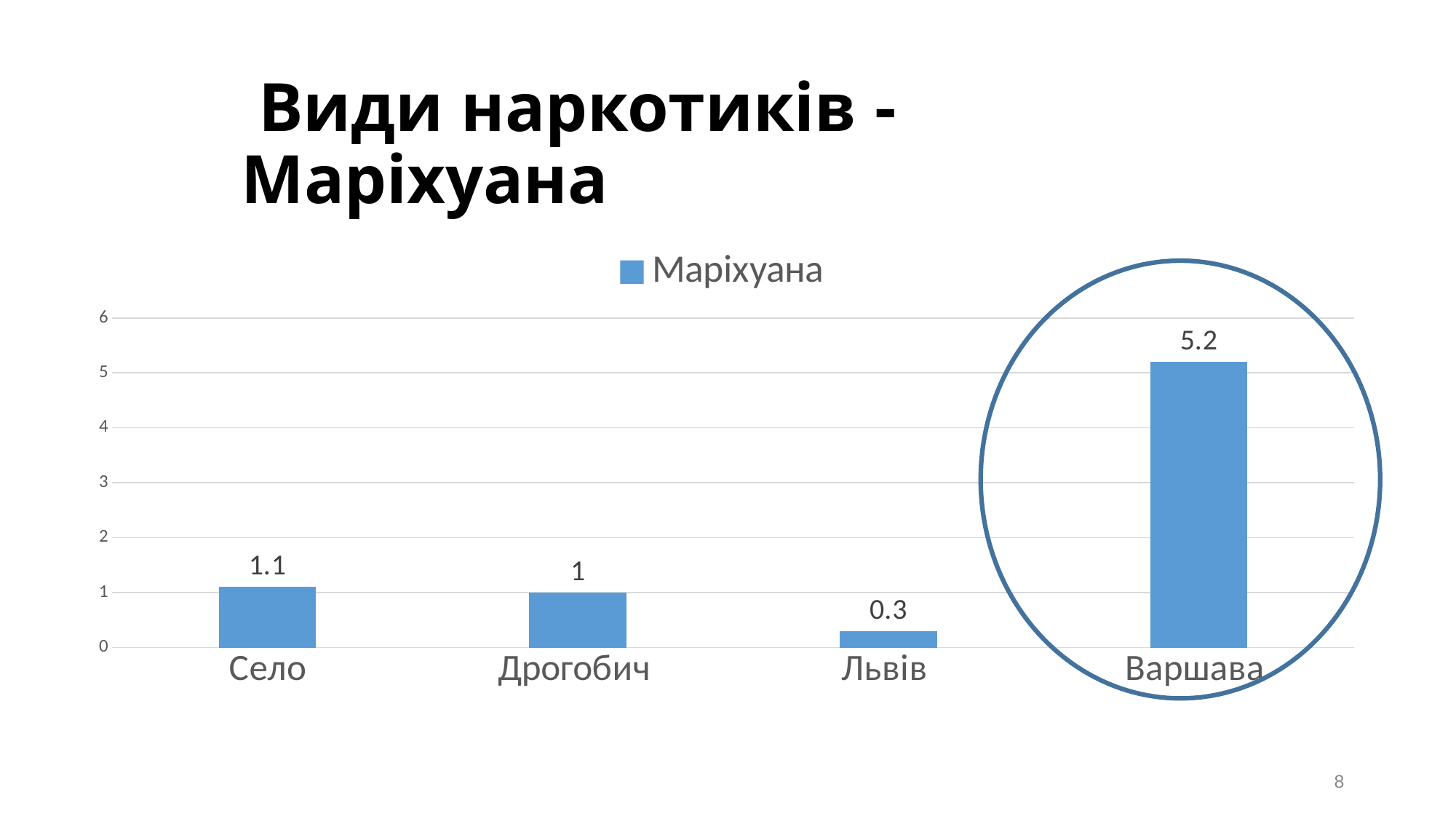
What is the value for Львів? 0.3 What kind of chart is shown? Bar chart Which category has the lowest value? Львів What is the difference between the values for Дрогобич and Львів? 0.7 What is the value for Село? 1.1 What is the difference between the values for Варшава and Село? 4.1 What series name does the legend show? Маріхуана How many categories are shown on the x axis? 4 Which category has the highest value? Варшава Which is larger, the value for Село or the value for Львів? Село What is the value for Дрогобич? 1 What is the value for Варшава? 5.2